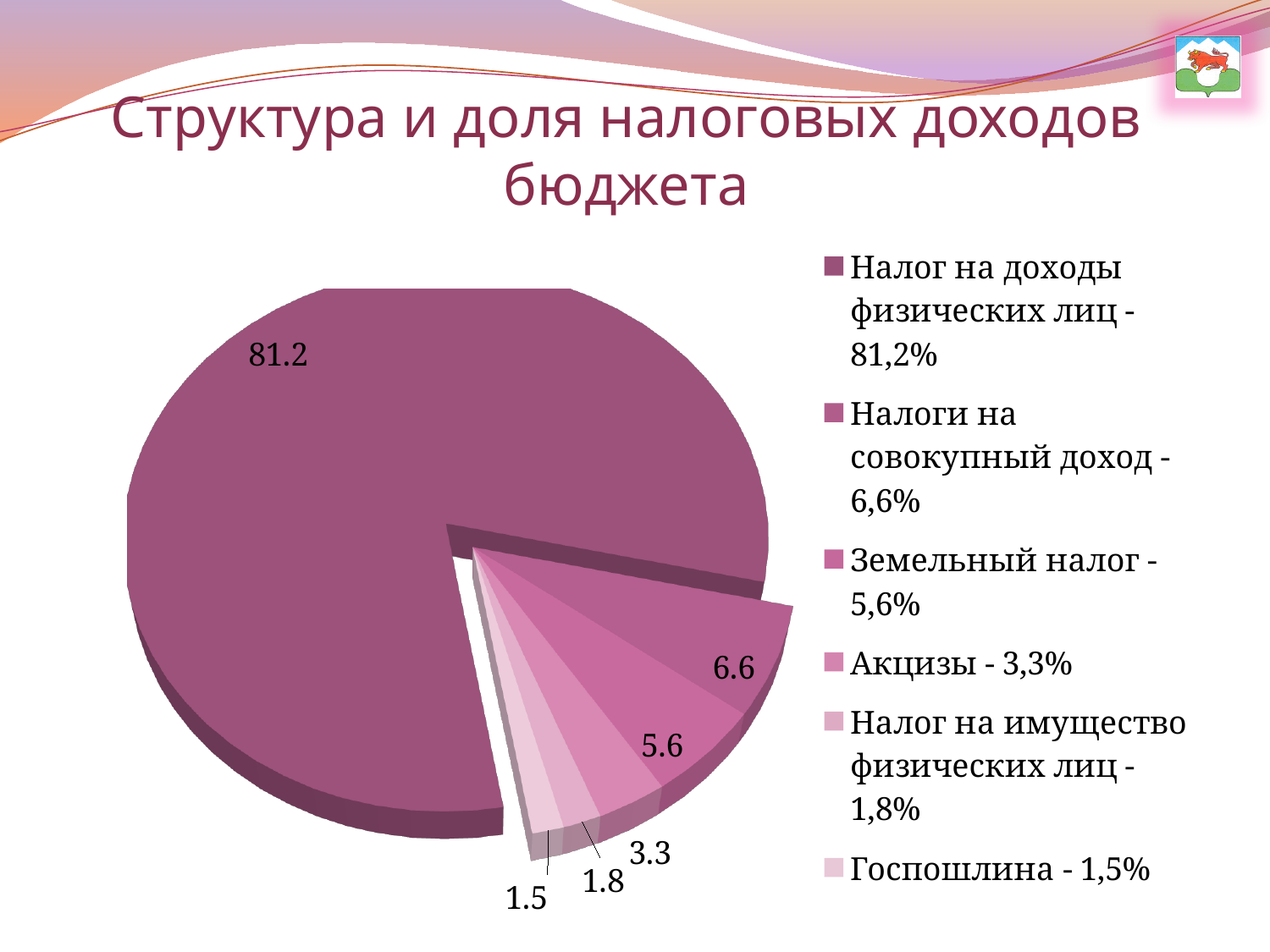
What is the value shown for Налоги на совокупный доход? 6.6 Which is larger, the value for Акцизы or the value for Налог на имущество физических лиц? Акцизы What is the value shown for Налог на доходы физических лиц? 81.2 Which category has the smallest slice of the pie? Госпошлина What is the value shown for Земельный налог? 5.6 What is the value shown for Госпошлина? 1.5 What is the value shown for Акцизы? 3.3 What is the title of the chart slide? Структура и доля налоговых доходов бюджета What is the difference between the values for Налоги на совокупный доход and Земельный налог? 1.0 What kind of chart is shown on the slide? pie chart How many categories does the legend list? 6 Which category has the largest slice of the pie? Налог на доходы физических лиц